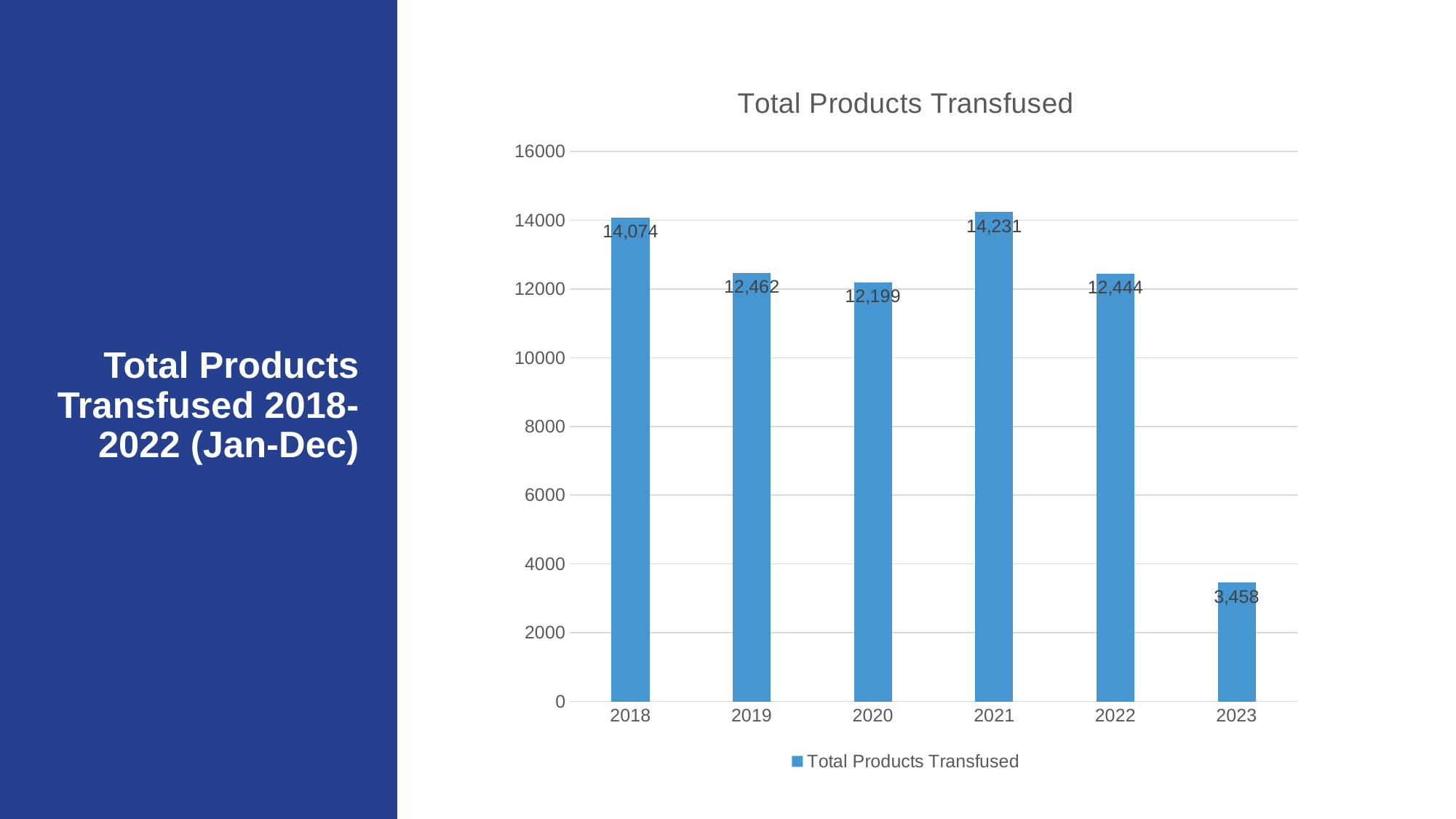
What is the title of the chart? Total Products Transfused What is the value for 2018? 14,074 Which year has the highest value? 2021 What is the difference between the values for 2021 and 2018? 157 What is the value for 2023? 3,458 Is the value for 2022 greater or less than 12000? greater Which year has the lowest value? 2023 Which is larger, the value for 2019 or the value for 2020? 2019 How many years are shown on the x axis? 6 What is the difference between the values for 2019 and 2020? 263 What is the value for 2021? 14,231 What kind of chart is shown? bar chart